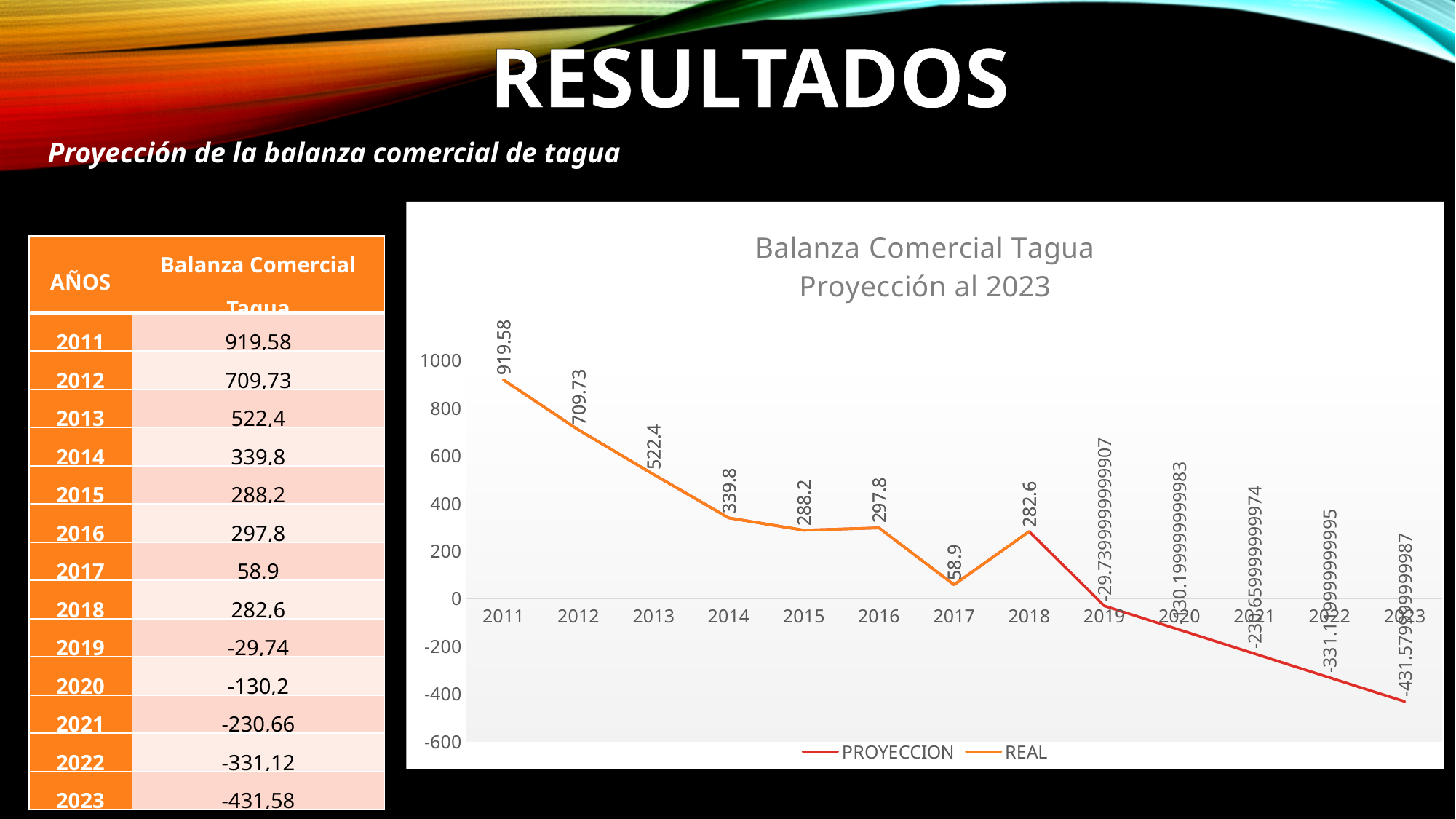
Which year has the lowest value in the chart? 2023 Which year has the highest value in the chart? 2011 What value does the chart show for 2017? 58.9 What is the difference between the values for 2011 and 2012? 209.85 How many years are plotted along the x axis of the chart? 13 What value does the chart show for 2013? 522.4 What is the value of the Balanza Comercial Tagua for 2011 in the chart? 919.58 Which year has the larger value, 2015 or 2016? 2016 How many series does the chart legend list? 2 What kind of chart is shown on the slide? line chart Is the value for 2022 greater or less than -200? less What value does the chart show for 2018? 282.6